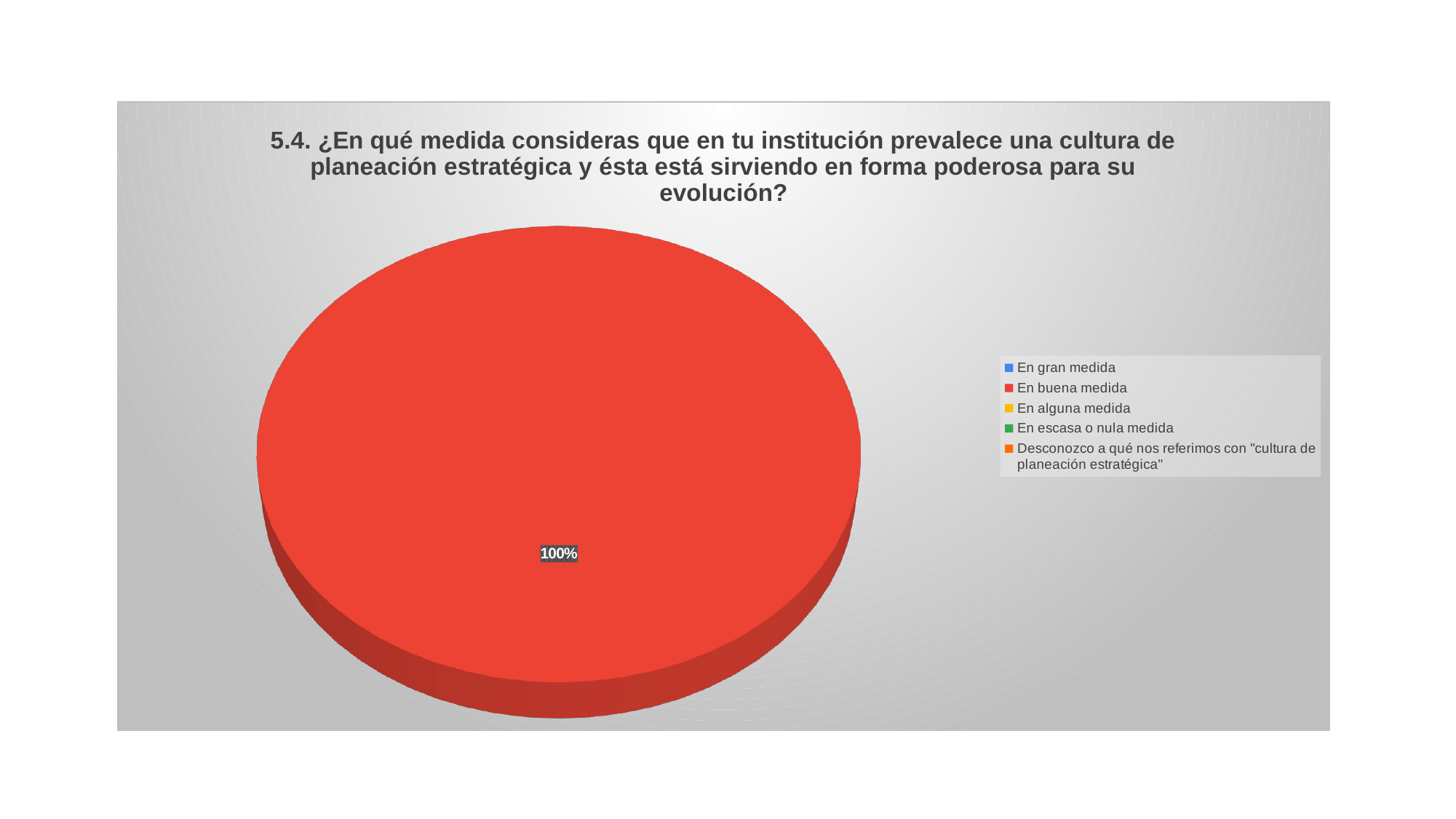
What share of the pie does "En buena medida" account for? 100% Is the share for "En buena medida" greater or less than 50%? greater How many slices are visible in the pie? 1 Which legend entry is shown in blue? En gran medida How many entries does the legend list? 5 What is the data label printed on the pie slice? 100% Which category makes up the entire pie? En buena medida What colour is the "En buena medida" slice? red What kind of chart is shown on the slide? pie chart